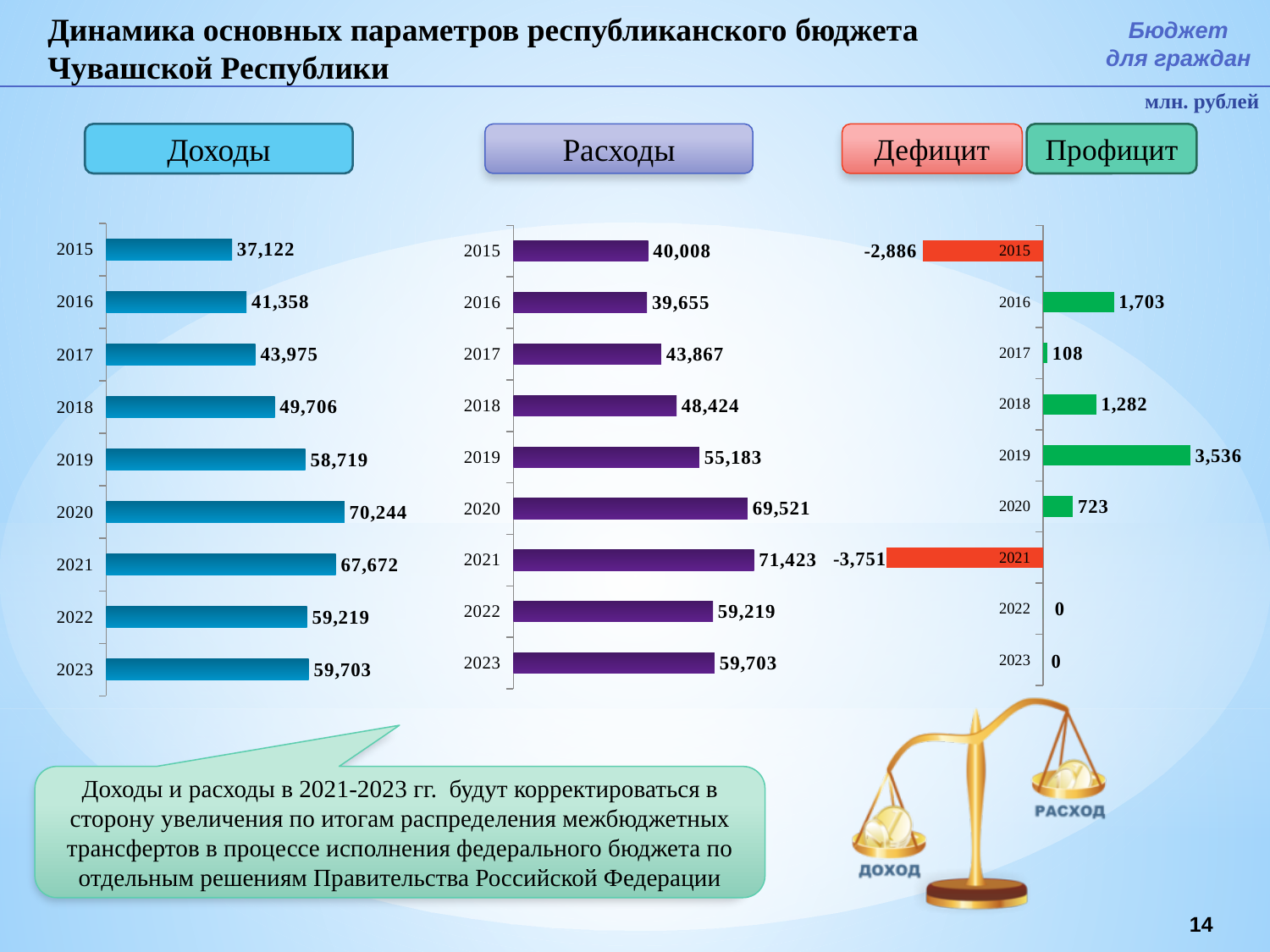
What type of chart is the Расходы chart? bar chart In the Дефицит/Профицит chart, what is the value for 2021? -3,751 What unit of measurement is indicated for the charts on the slide? млн. рублей In the Доходы chart, what is the difference between the values for 2020 and 2021? 2,572 In the Дефицит/Профицит chart, which years show a deficit (red bars)? 2015 and 2021 In the Дефицит/Профицит chart, what is the value for 2019? 3,536 In the Расходы chart, which is larger, the value for 2015 or the value for 2016? 2015 In the Расходы chart, what is the value for 2021? 71,423 How many years are shown in the Доходы chart? 9 In the Расходы chart, which year has the lowest value? 2016 In the Доходы chart, what is the value for 2020? 70,244 In the Доходы chart, which year has the highest value? 2020